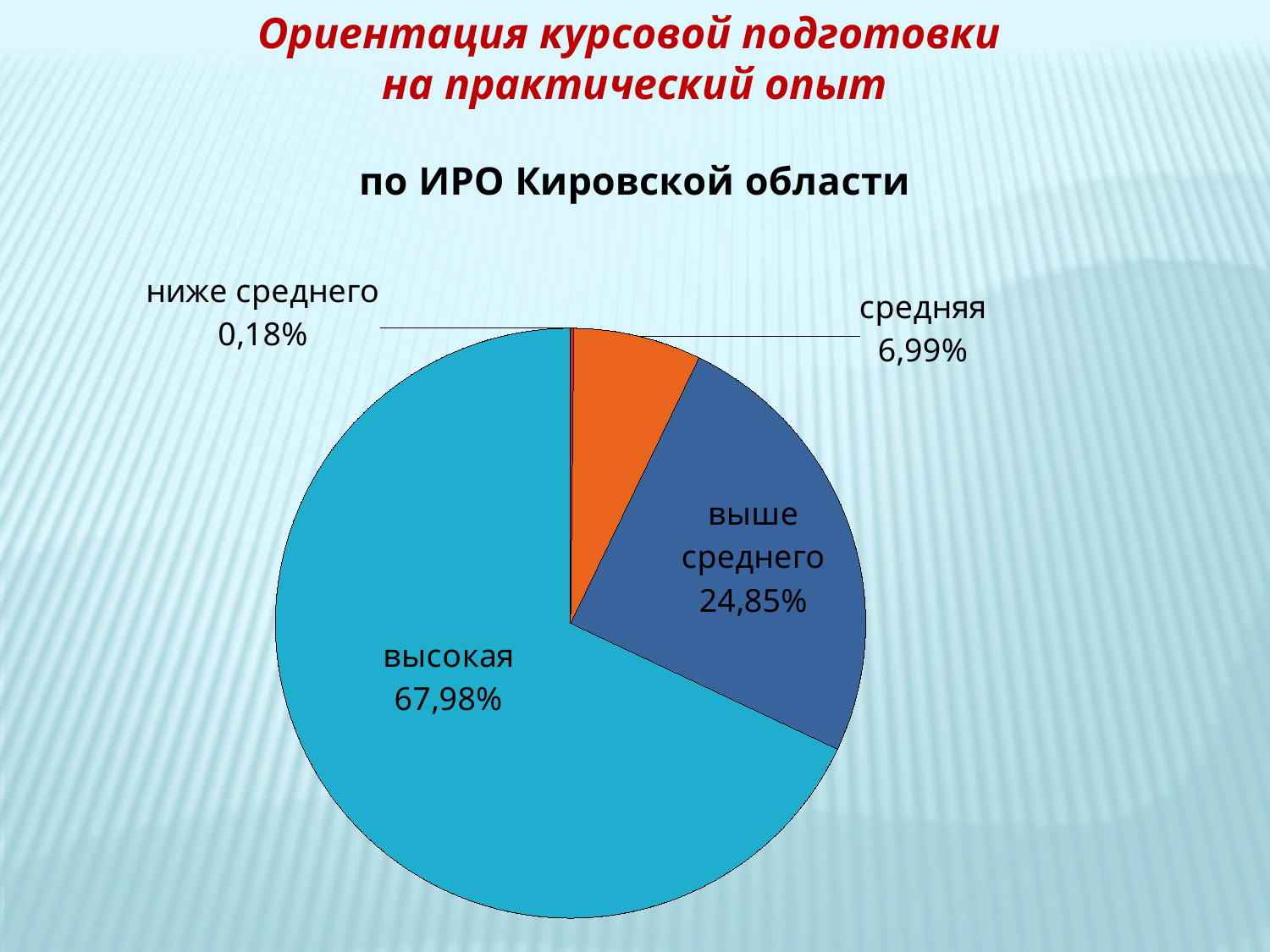
What is the value for the "высокая" slice? 67,98% Which is larger, the "средняя" slice or the "выше среднего" slice? выше среднего Which category has the largest share of the pie? высокая What is the value for the "ниже среднего" slice? 0,18% What type of chart is shown on the slide? pie chart What is the value for the "средняя" slice? 6,99% What is the value for the "выше среднего" slice? 24,85% What is the title of the chart? по ИРО Кировской области How many slices does the pie chart have? 4 Which category has the smallest share of the pie? ниже среднего What is the difference between the "высокая" and "выше среднего" values? 43,13% What colour is the "выше среднего" slice? dark blue